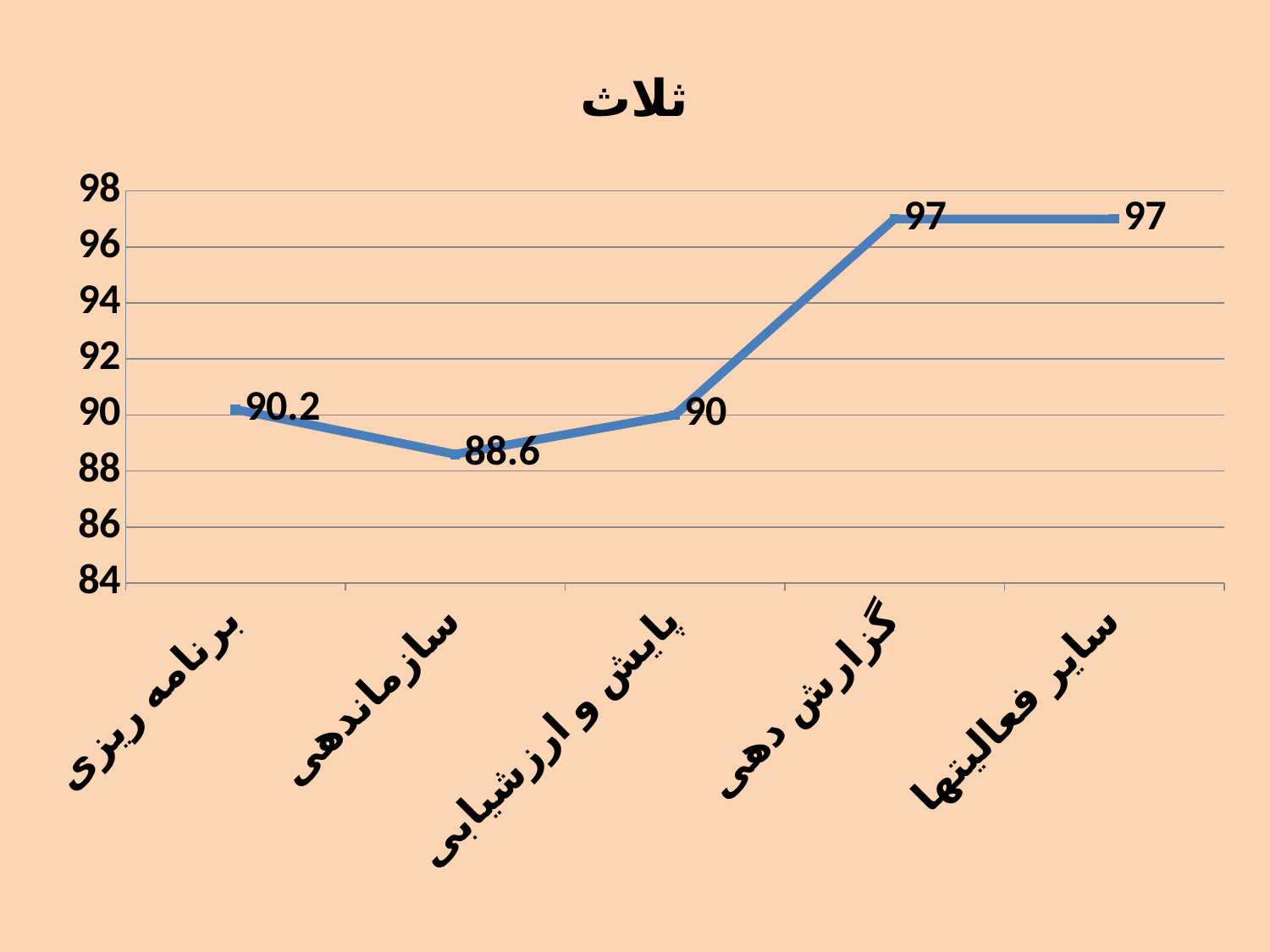
Which is larger, the value for برنامه ریزی or the value for سازماندهی? برنامه ریزی How many categories are plotted on the x axis? 5 What is the title of the chart? ثلاث Is the value for سایر فعالیتها greater or less than 94? greater What is the value for گزارش دهی? 97 What is the value for پایش و ارزشیابی? 90 What is the difference between the values for گزارش دهی and سازماندهی? 8.4 What kind of chart is shown on the slide? line chart What is the difference between the values for برنامه ریزی and پایش و ارزشیابی? 0.2 What is the value for سازماندهی? 88.6 What is the value for برنامه ریزی? 90.2 Which category has the lowest value? سازماندهی